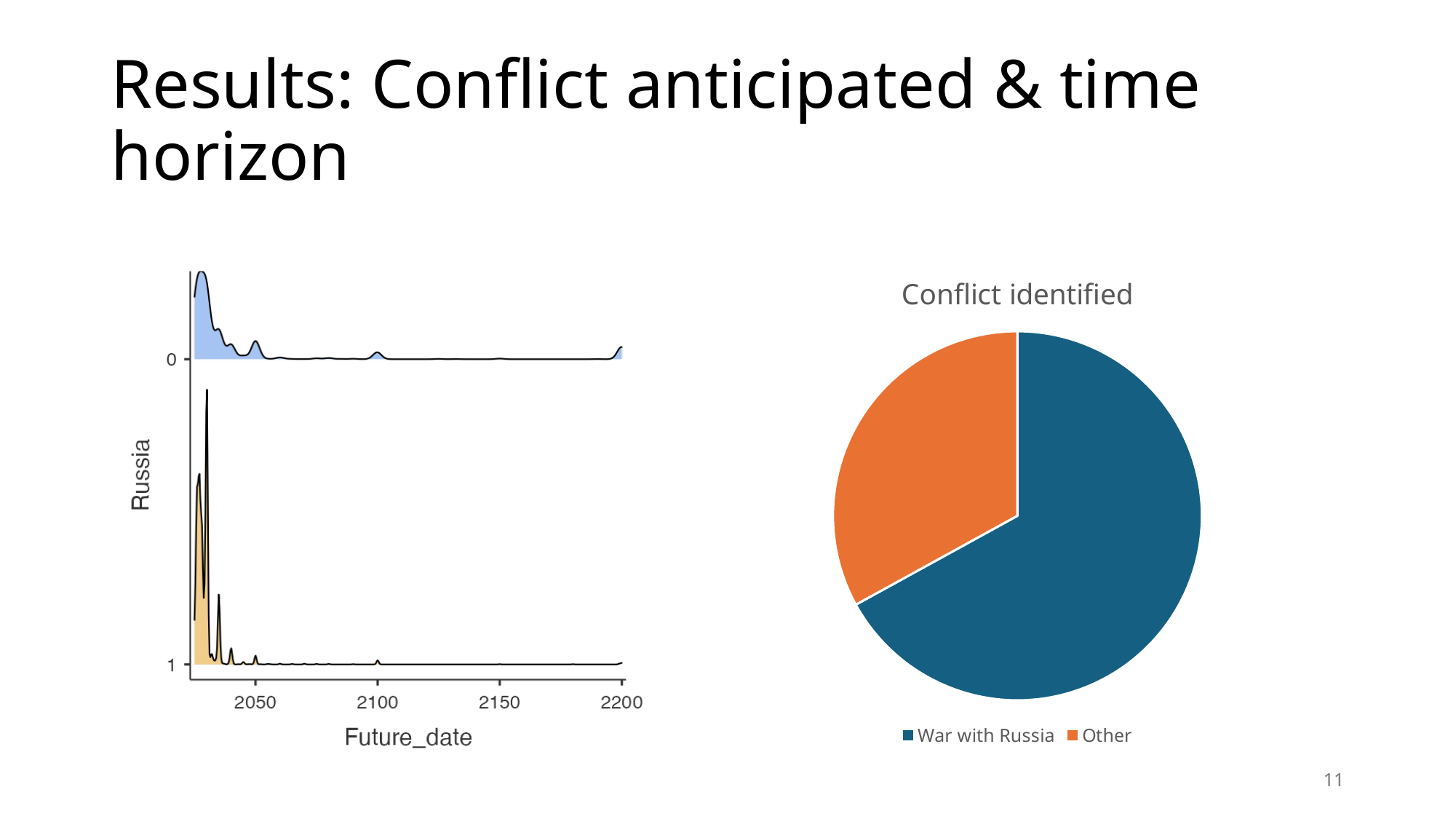
In the pie chart titled 'Conflict identified', which slice is the smallest? Other How many entries does the legend of the pie chart titled 'Conflict identified' list? 2 What kind of chart is the chart titled 'Conflict identified'? Pie chart In the pie chart titled 'Conflict identified', what colour is the 'Other' slice? Orange What is the x-axis label of the chart on the left of the slide? Future_date How many slices does the pie chart titled 'Conflict identified' have? 2 In the pie chart titled 'Conflict identified', which is larger: the 'War with Russia' slice or the 'Other' slice? War with Russia What is the title of the pie chart on the right of the slide? Conflict identified In the pie chart titled 'Conflict identified', which slice is the largest? War with Russia How many rows (y-axis categories) does the chart on the left of the slide show? 2